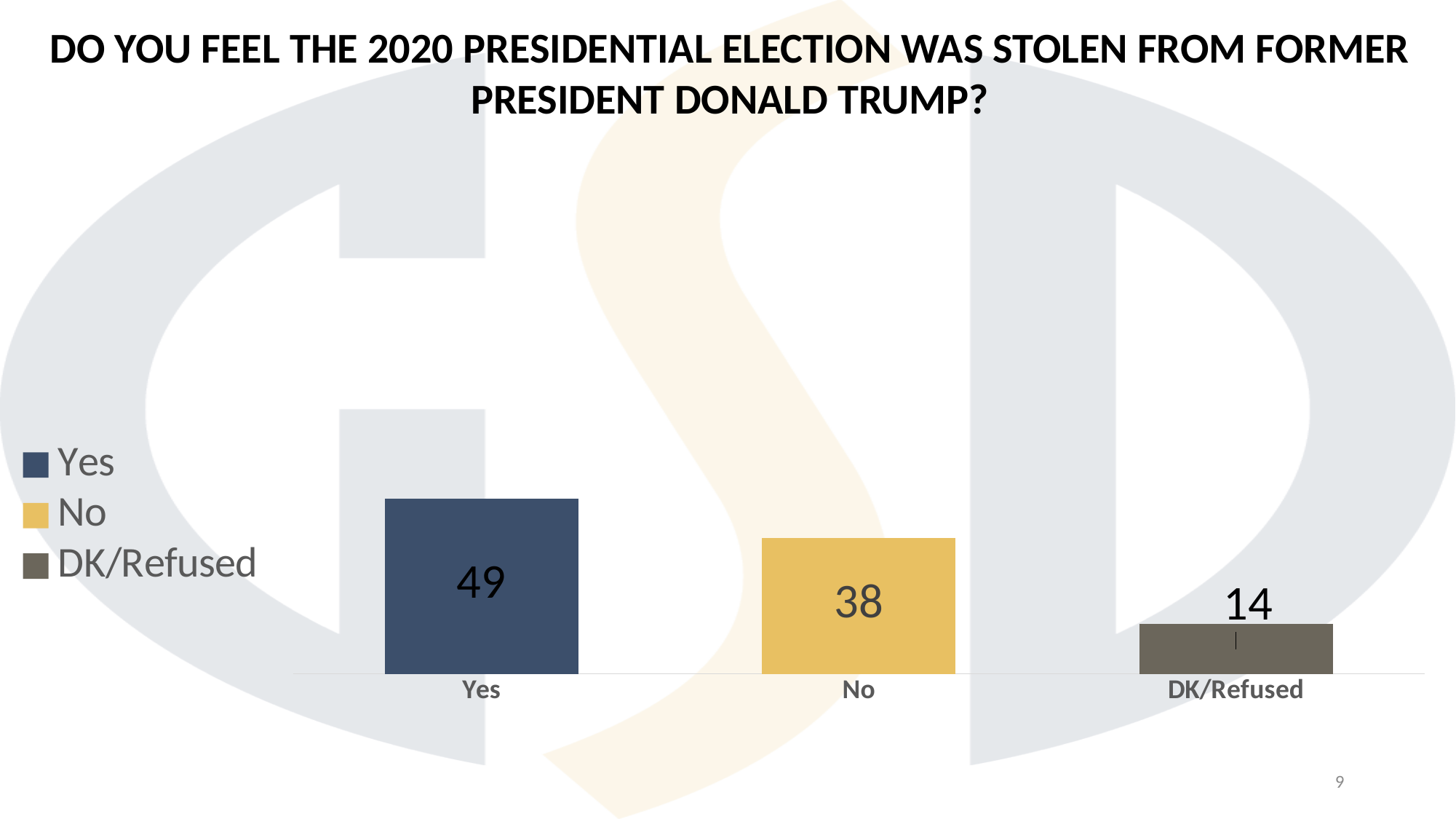
What is the value for DK/Refused? 14 How many entries does the legend list? 3 Which category has the lowest value? DK/Refused What colour is the bar for No? Yellow What is the value for Yes? 49 What is the difference between the values for No and DK/Refused? 24 Which is larger, the value for Yes or the value for No? Yes Which category has the highest value? Yes What is the difference between the values for Yes and No? 11 What is the value for No? 38 How many categories are shown in the chart? 3 What kind of chart is shown on the slide? Bar chart